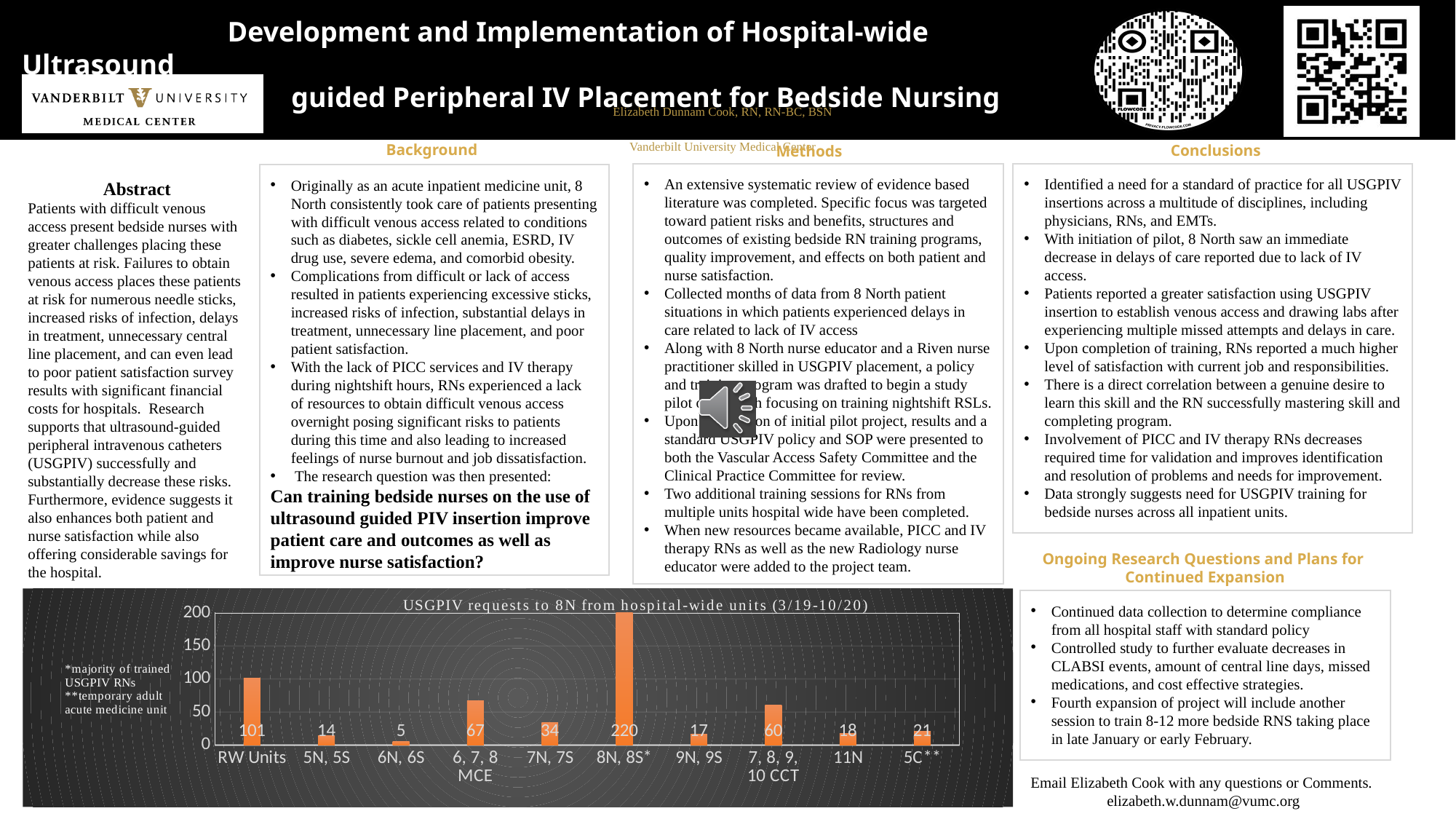
What type of chart is shown on the slide? bar chart Which had more USGPIV requests, 7N, 7S or 5C**? 7N, 7S What is the difference in USGPIV requests between 11N and 9N, 9S? 1 What is the title of the chart on the slide? USGPIV requests to 8N from hospital-wide units (3/19-10/20) What is the difference in USGPIV requests between 8N, 8S* and RW Units? 119 How many USGPIV requests came from RW Units? 101 How many USGPIV requests came from 6, 7, 8 MCE? 67 Which unit had the highest number of USGPIV requests? 8N, 8S* Is the value for 8N, 8S* greater or less than 200? greater How many USGPIV requests came from 7, 8, 9, 10 CCT? 60 Which unit had the lowest number of USGPIV requests? 6N, 6S How many categories (units) are shown on the x axis of the chart? 10